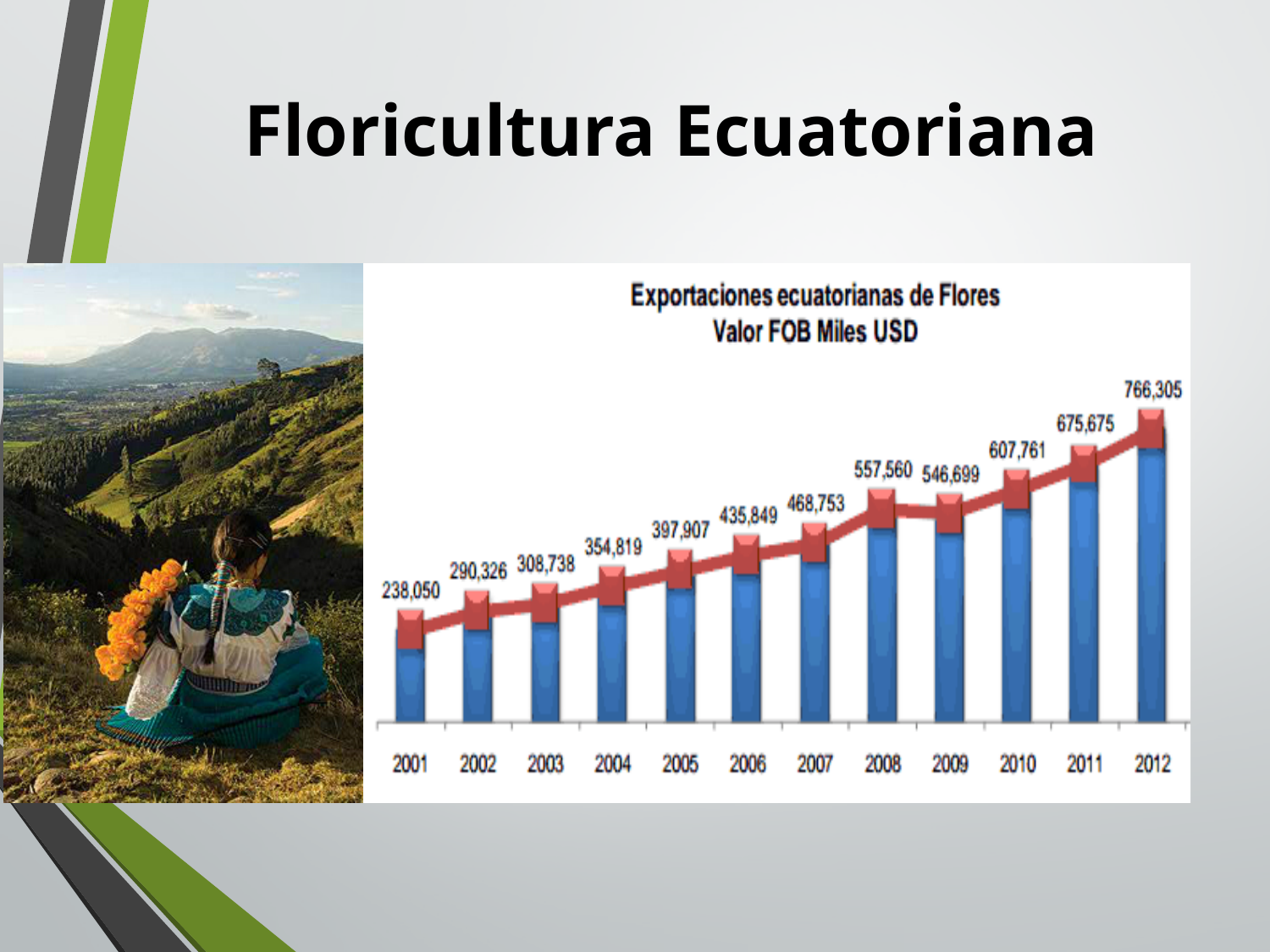
What is the value for 2001 in the chart? 238,050 Which year has the lowest value in the chart? 2001 What is the difference between the values for 2012 and 2011? 90,630 What is the value for 2005 in the chart? 397,907 How many years are shown on the x axis of the chart? 12 What is the difference between the values for 2008 and 2009? 10,861 Which year has the highest value in the chart? 2012 What is the value for 2008 in the chart? 557,560 What is the value for 2012 in the chart? 766,305 What kind of chart is shown on the slide? Bar chart Which is larger, the value for 2008 or the value for 2009? 2008 What is the title of the chart? Exportaciones ecuatorianas de Flores Valor FOB Miles USD